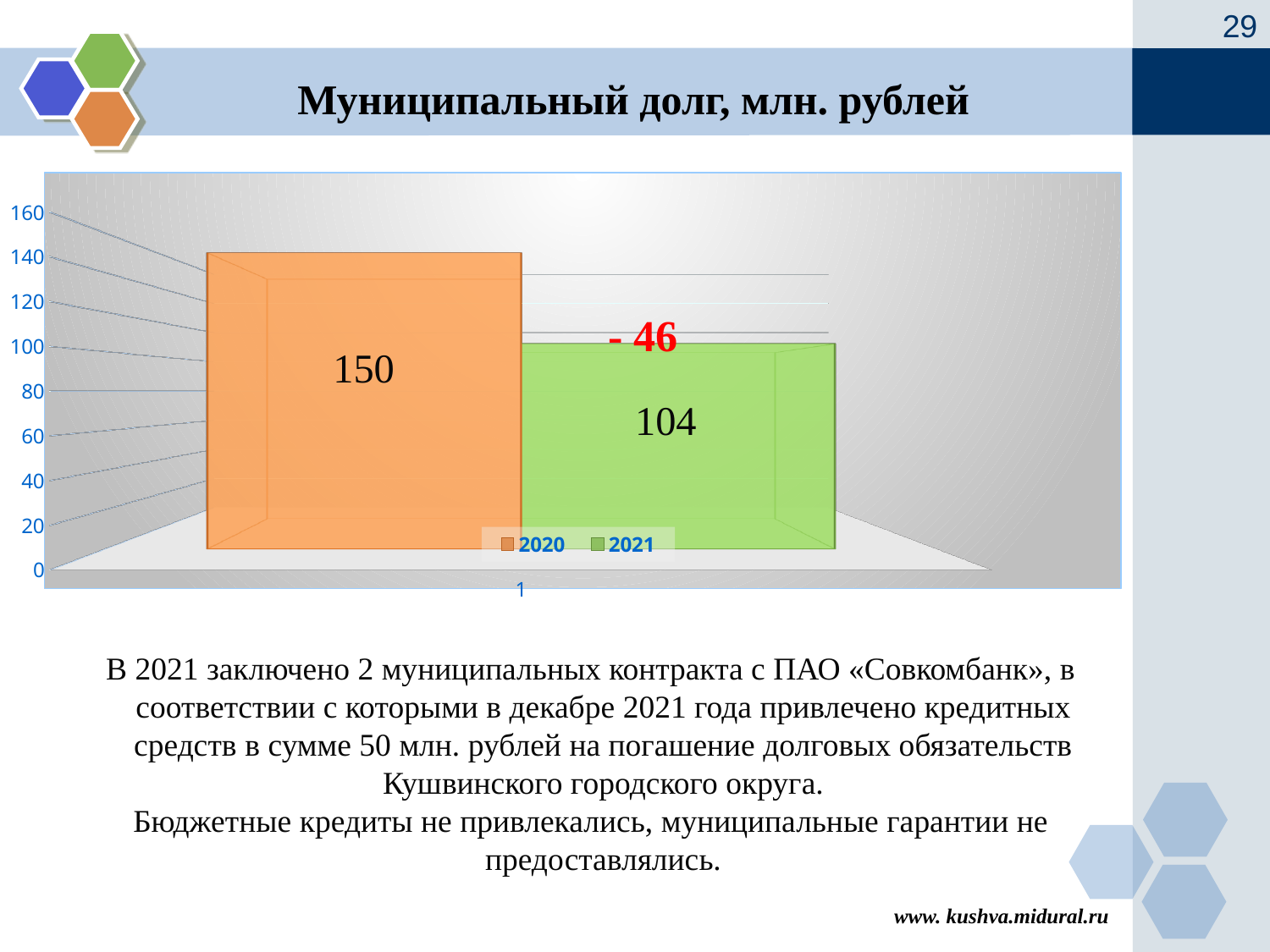
What is the value for 2021 in the chart? 104 Is the value for 2021 greater or less than 120? less Which series has the lowest value in the chart? 2021 What is the value for 2020 in the chart? 150 Is the value for 2020 greater or less than 140? greater What colour is the bar for 2021? green Which series has the higher value, 2020 or 2021? 2020 How many series does the legend list? 2 What kind of chart is shown on the slide? bar chart Did the municipal debt rise or fall from 2020 to 2021? fall What is the title of the chart? Муниципальный долг, млн. рублей What is the difference between the 2020 and 2021 values? 46